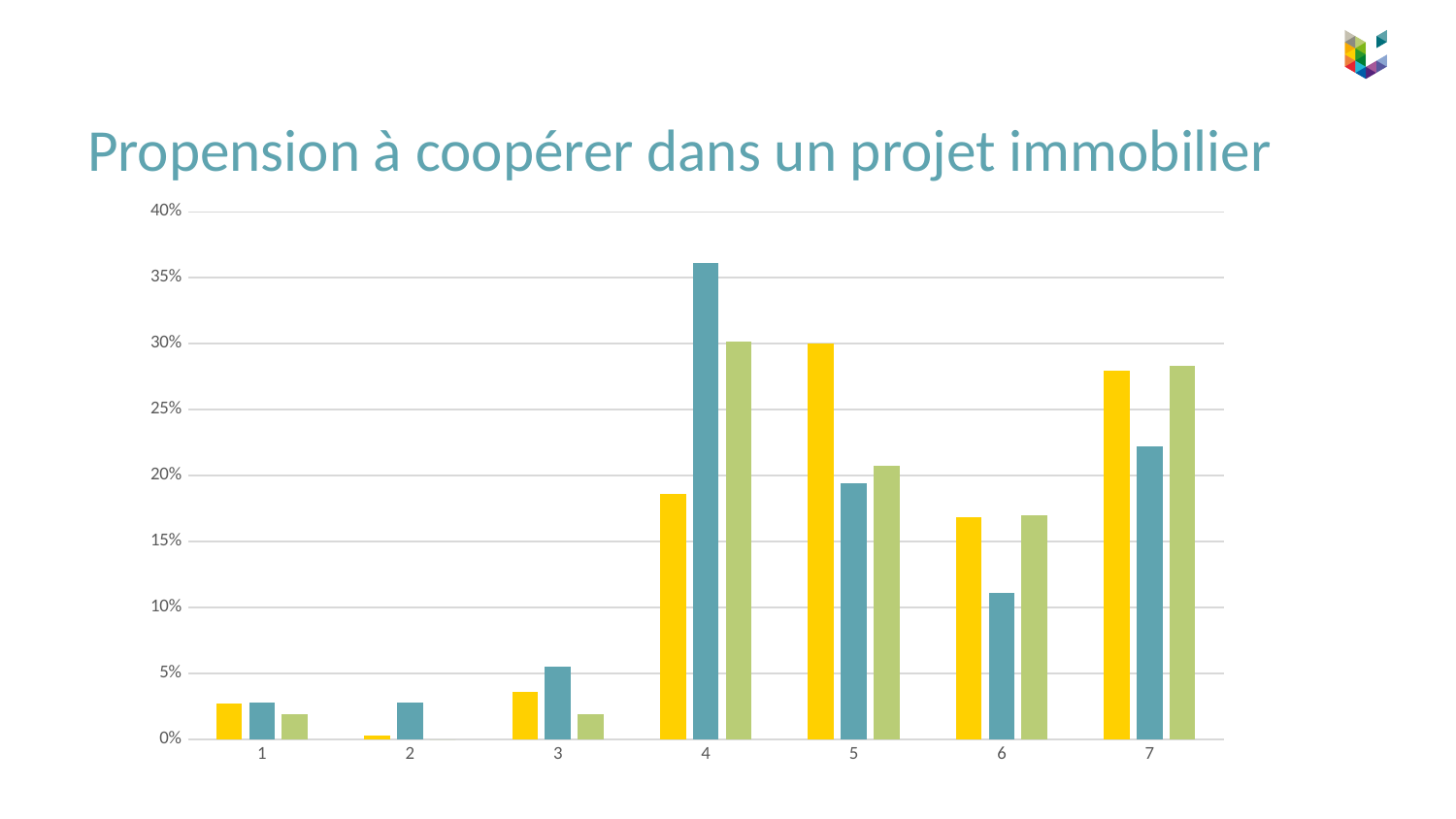
How many categories are shown along the x axis? 7 In category 4, which is larger, the yellow bar or the teal bar? the teal bar How many bars are plotted for each category? 3 Is the yellow bar for category 4 greater or less than 20%? less Which category has the tallest teal (middle) bar? 4 What kind of chart is shown on the slide? bar chart Which category has the lowest green (right) bar? 2 Is the teal bar for category 6 greater or less than 15%? less Which category has the lowest yellow (left) bar? 2 What is the title of the chart? Propension à coopérer dans un projet immobilier Is the teal bar for category 4 greater or less than 30%? greater In category 5, which is larger, the yellow bar or the teal bar? the yellow bar